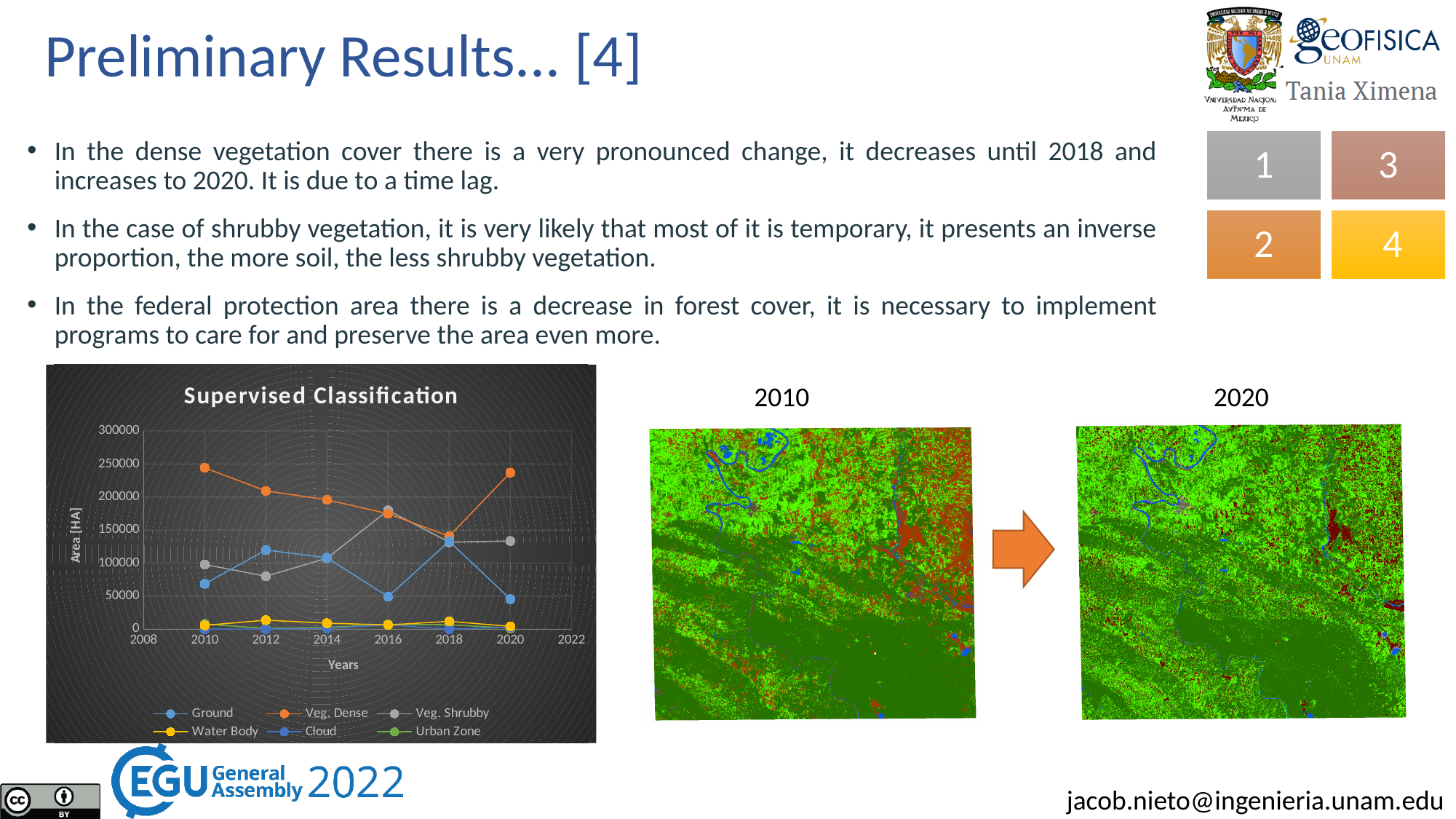
In the "Supervised Classification" chart, in which year does Veg. Dense reach its lowest value? 2018 In the "Supervised Classification" chart, is the Veg. Shrubby value for 2016 greater or less than 150000? greater In the "Supervised Classification" chart, is the Veg. Dense value for 2016 greater or less than 150000? greater In the "Supervised Classification" chart, is the Veg. Dense value for 2010 greater or less than 200000? greater How many series does the legend of the "Supervised Classification" chart list? 6 What kind of chart is the "Supervised Classification" chart? line chart In the "Supervised Classification" chart, which is larger in 2016: Ground or Veg. Shrubby? Veg. Shrubby In the "Supervised Classification" chart, which is larger in 2010: Veg. Dense or Veg. Shrubby? Veg. Dense In the "Supervised Classification" chart, does the Veg. Dense series rise or fall from 2010 to 2018? fall In the "Supervised Classification" chart, which series has the highest value in 2010? Veg. Dense How many years have data points plotted in the "Supervised Classification" chart? 6